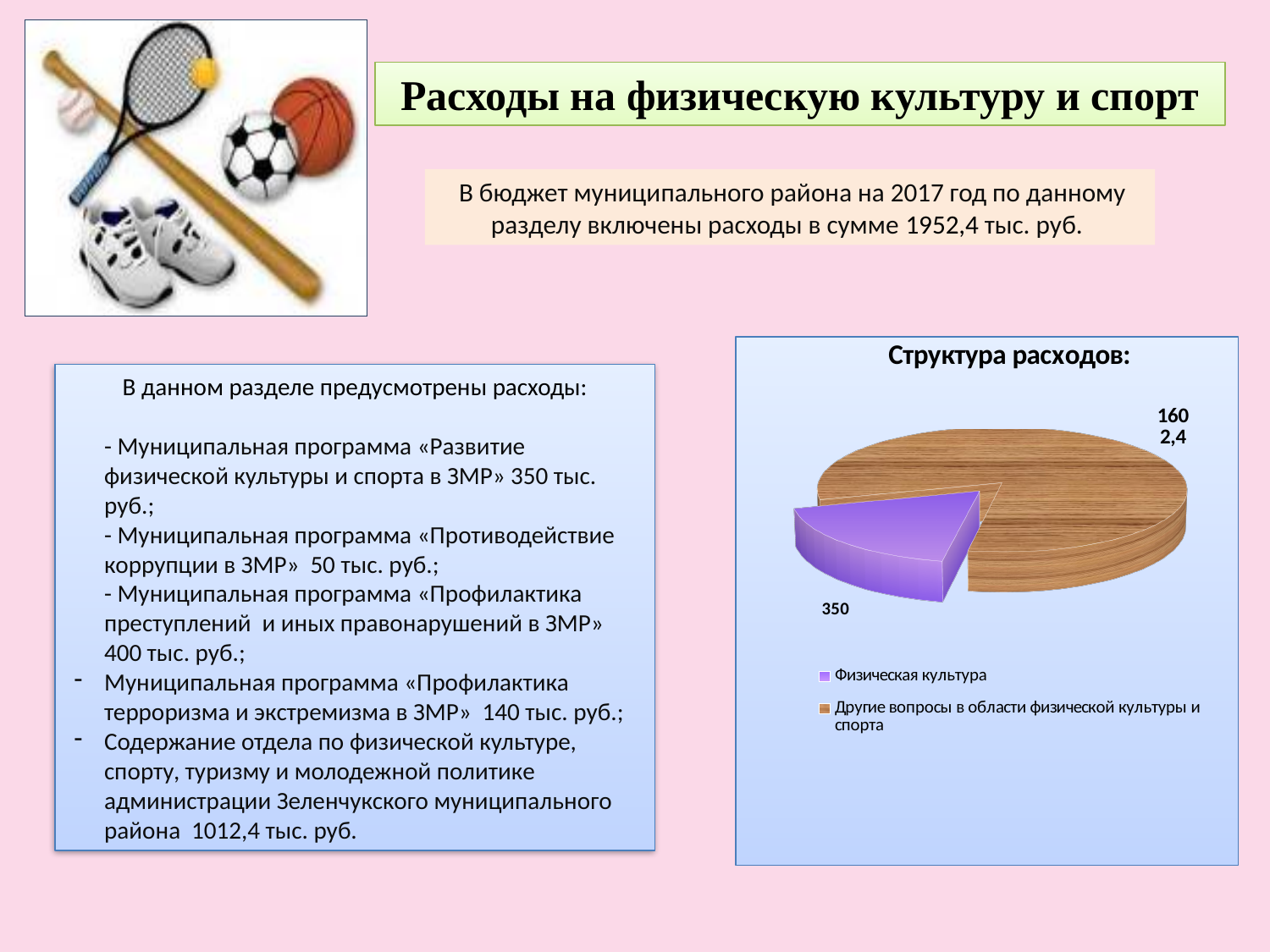
In the pie chart «Структура расходов:», what is the difference between «Другие вопросы в области физической культуры и спорта» and «Физическая культура»? 1252,4 In the pie chart «Структура расходов:», what is the value for «Физическая культура»? 350 Which slice of the pie chart «Структура расходов:» is the smallest? Физическая культура What colour is the «Физическая культура» slice in the pie chart «Структура расходов:»? Purple How many entries does the legend of the pie chart «Структура расходов:» list? 2 In the pie chart «Структура расходов:», what is the value for «Другие вопросы в области физической культуры и спорта»? 1602,4 What is the total of the two slices in the pie chart «Структура расходов:»? 1952,4 Which slice of the pie chart «Структура расходов:» is the largest? Другие вопросы в области физической культуры и спорта In the pie chart «Структура расходов:», which is larger: «Физическая культура» or «Другие вопросы в области физической культуры и спорта»? Другие вопросы в области физической культуры и спорта What kind of chart is shown under the title «Структура расходов:»? Pie chart What is the title of the pie chart on the slide? Структура расходов: How many slices does the pie chart «Структура расходов:» have? 2